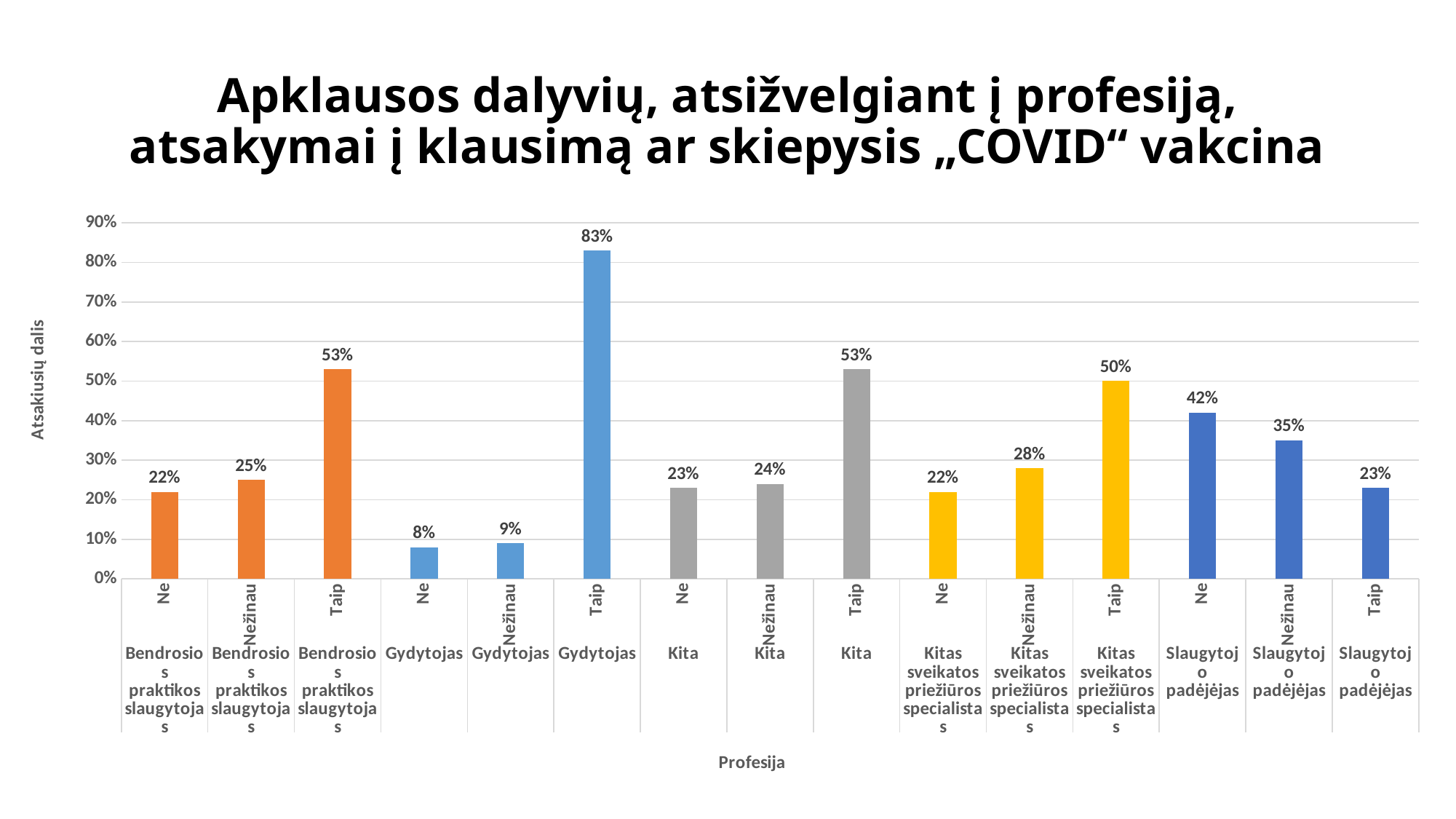
What is the value for "Ne" among Gydytojas? 8% What is the value for "Ne" among Slaugytojo padėjėjas? 42% What is the value for "Nežinau" among Kitas sveikatos priežiūros specialistas? 28% Which bar has the lowest value in the chart? Gydytojas – Ne (8%) What is the title of the vertical axis? Atsakiusių dalis Is the "Taip" value for Kitas sveikatos priežiūros specialistas greater or less than 40%? greater Which is larger: "Ne" for Slaugytojo padėjėjas or "Taip" for Slaugytojo padėjėjas? Ne for Slaugytojo padėjėjas (42%) What type of chart is shown on the slide? Bar chart What is the difference between the "Taip" value for Gydytojas and the "Taip" value for Kita? 30% What percentage of Gydytojas respondents answered "Taip"? 83% How many bars are plotted in the chart? 15 Which bar has the highest value in the chart? Gydytojas – Taip (83%)